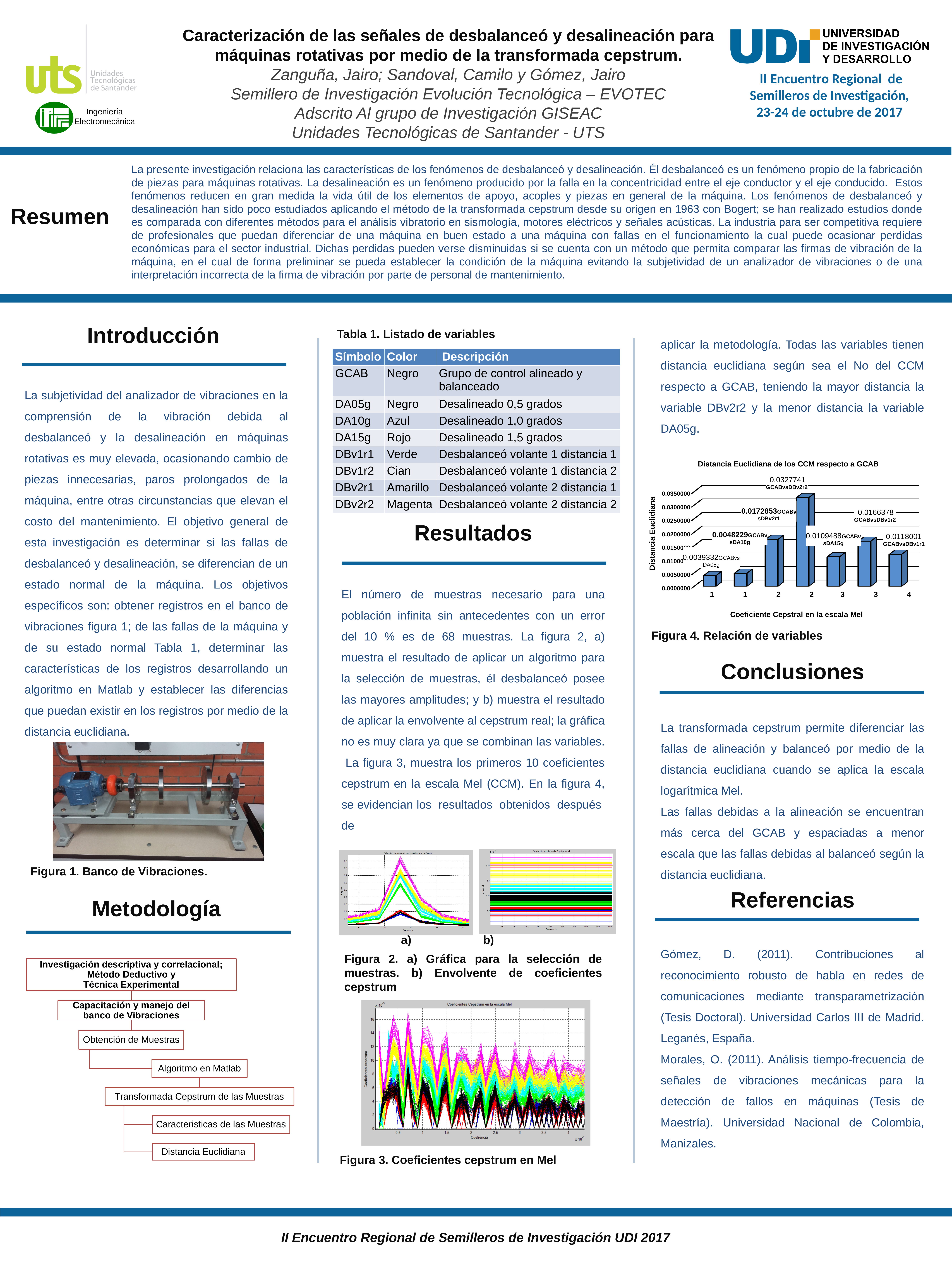
What kind of chart is 'Distancia Euclidiana de los CCM respecto a GCAB'? bar chart In the chart 'Distancia Euclidiana de los CCM respecto a GCAB', which is larger: GCABvsDBv2r1 or GCABvsDBv1r2? GCABvsDBv2r1 In the chart 'Distancia Euclidiana de los CCM respecto a GCAB', what is the value for GCABvsDBv2r2? 0.0327741 In the chart 'Distancia Euclidiana de los CCM respecto a GCAB', which comparison has the lowest value? GCABvsDA05g In the chart 'Distancia Euclidiana de los CCM respecto a GCAB', what is the value for GCABvsDA05g? 0.0039332 In the chart 'Distancia Euclidiana de los CCM respecto a GCAB', which comparison has the highest value? GCABvsDBv2r2 In the chart 'Distancia Euclidiana de los CCM respecto a GCAB', what is the difference between the values for GCABvsDA10g and GCABvsDA05g? 0.0008897 In the chart 'Distancia Euclidiana de los CCM respecto a GCAB', what is the value for GCABvsDA15g? 0.0109488 What is the title of the vertical axis in the chart 'Distancia Euclidiana de los CCM respecto a GCAB'? Distancia Euclidiana In the chart 'Distancia Euclidiana de los CCM respecto a GCAB', what is the difference between the values for GCABvsDBv2r2 and GCABvsDBv2r1? 0.0154888 How many bars are plotted in the chart 'Distancia Euclidiana de los CCM respecto a GCAB'? 7 In the chart 'Distancia Euclidiana de los CCM respecto a GCAB', is the value for GCABvsDBv2r2 greater or less than 0.0300000? greater